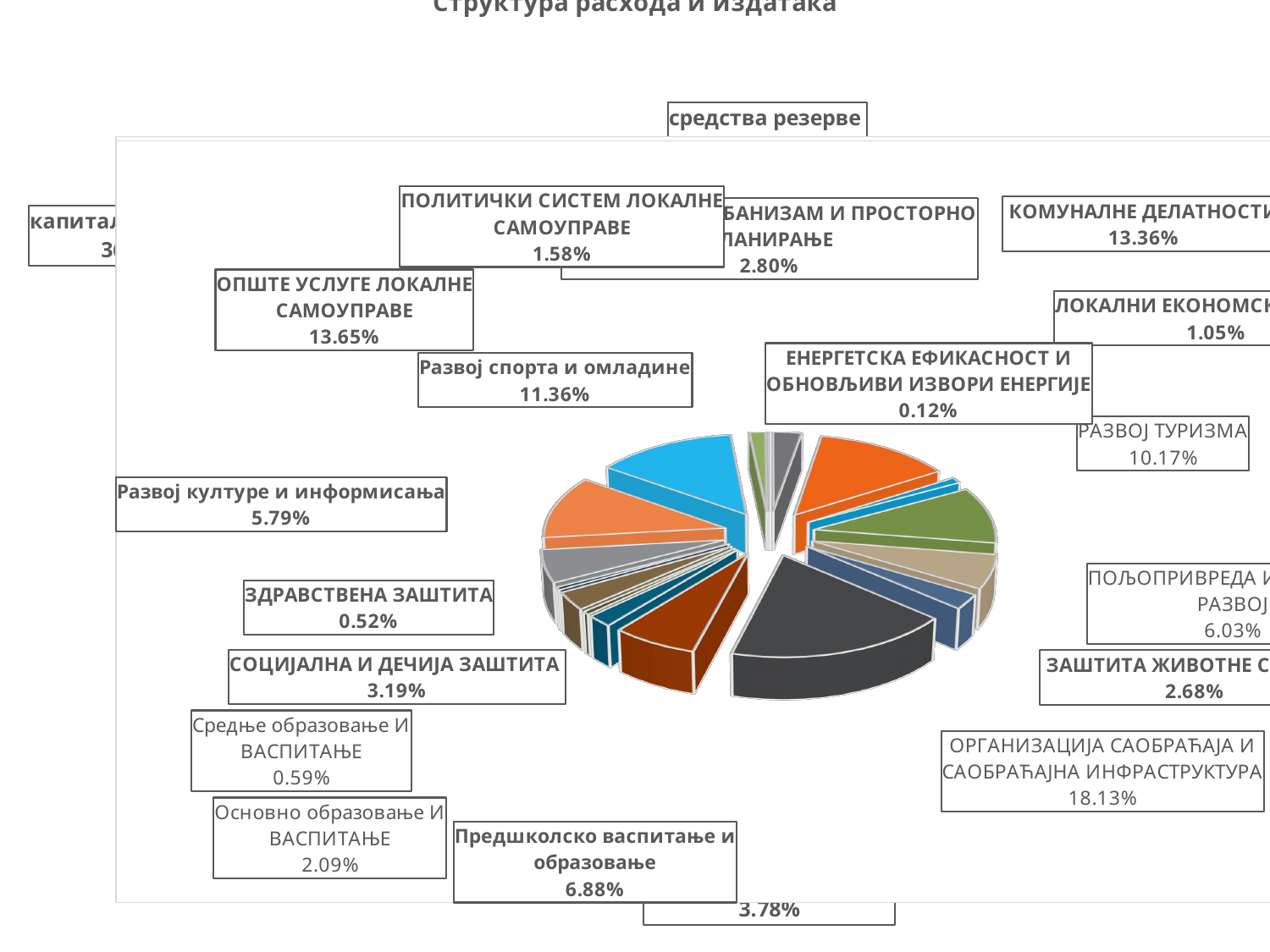
What percentage is shown for ЗДРАВСТВЕНА ЗАШТИТА? 0.52% What percentage is labelled for Развој спорта и омладине? 11.36% What share does ОРГАНИЗАЦИЈА САОБРАЋАЈА И САОБРАЋАЈНА ИНФРАСТРУКТУРА have in the pie chart? 18.13% What is the difference between the shares of ОПШТЕ УСЛУГЕ ЛОКАЛНЕ САМОУПРАВЕ and КОМУНАЛНЕ ДЕЛАТНОСТИ? 0.29% What is the value for ЕНЕРГЕТСКА ЕФИКАСНОСТ И ОБНОВЉИВИ ИЗВОРИ ЕНЕРГИЈЕ? 0.12% What is the value labelled for РАЗВОЈ ТУРИЗМА? 10.17% Which is larger, the share for Развој спорта и омладине or the share for РАЗВОЈ ТУРИЗМА? Развој спорта и омладине What is the value shown for ОПШТЕ УСЛУГЕ ЛОКАЛНЕ САМОУПРАВЕ? 13.65% What share is shown for Предшколско васпитање и образовање? 6.88% Which category has the largest share in the pie chart? ОРГАНИЗАЦИЈА САОБРАЋАЈА И САОБРАЋАЈНА ИНФРАСТРУКТУРА What kind of chart is shown on the slide? pie chart What is the difference between the shares of ОРГАНИЗАЦИЈА САОБРАЋАЈА И САОБРАЋАЈНА ИНФРАСТРУКТУРА and РАЗВОЈ ТУРИЗМА? 7.96%